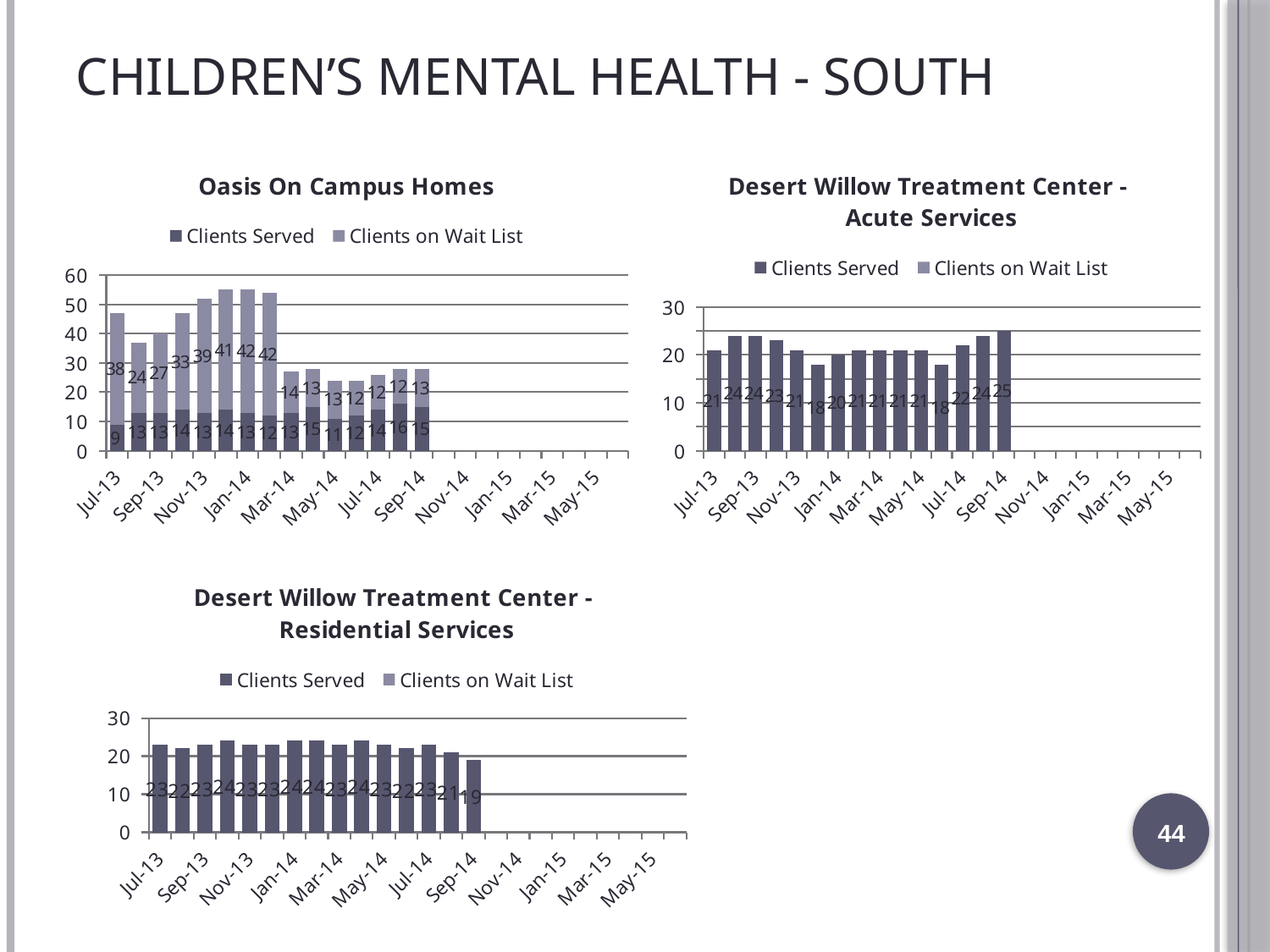
How many charts are shown on the slide? 3 In the Oasis On Campus Homes chart, which is larger: Clients on Wait List for Jul-13 or for Sep-14? Jul-13 In the Desert Willow Treatment Center - Residential Services chart, how many Clients Served are shown for Sep-14? 19 How many series does the legend of the Oasis On Campus Homes chart list? 2 In the Desert Willow Treatment Center - Residential Services chart, which month has the lowest number of Clients Served? Sep-14 In the Oasis On Campus Homes chart, how many Clients on Wait List are shown for Jan-14? 42 What kind of chart is the Oasis On Campus Homes chart? Stacked bar chart In the Desert Willow Treatment Center - Acute Services chart, what is the difference in Clients Served between Sep-13 and Jan-14? 4 In the Oasis On Campus Homes chart, what is the total of the stacked bar for Jan-14 (Clients Served plus Clients on Wait List)? 55 In the Desert Willow Treatment Center - Acute Services chart, how many Clients Served are shown for Sep-14? 25 In the Oasis On Campus Homes chart, how many Clients Served are shown for Jul-13? 9 In the Desert Willow Treatment Center - Acute Services chart, which month has the highest number of Clients Served? Sep-14